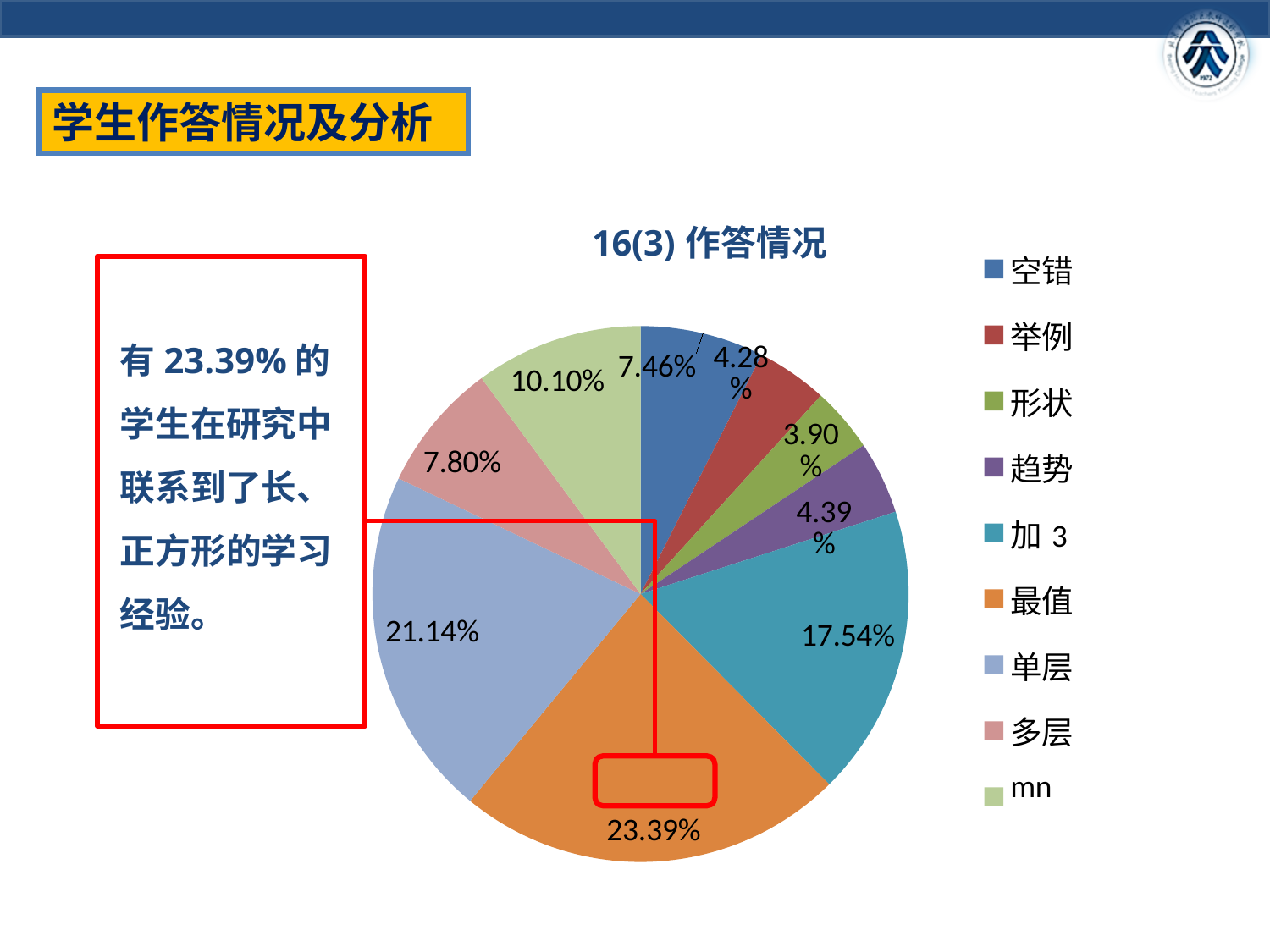
What percentage is shown for 单层? 21.14% What is the difference between the shares for 最值 and 单层? 2.25% What percentage is shown for 最值? 23.39% What percentage is shown for 加 3? 17.54% Which category has the smallest share of the pie? 形状 What percentage is shown for mn? 10.10% What percentage is shown for 空错? 7.46% What kind of chart is shown on the slide? pie chart Which category has the largest share of the pie? 最值 How many slices does the pie chart have? 9 What is the title of the chart? 16(3) 作答情况 Which is larger, the share for 多层 or the share for mn? mn